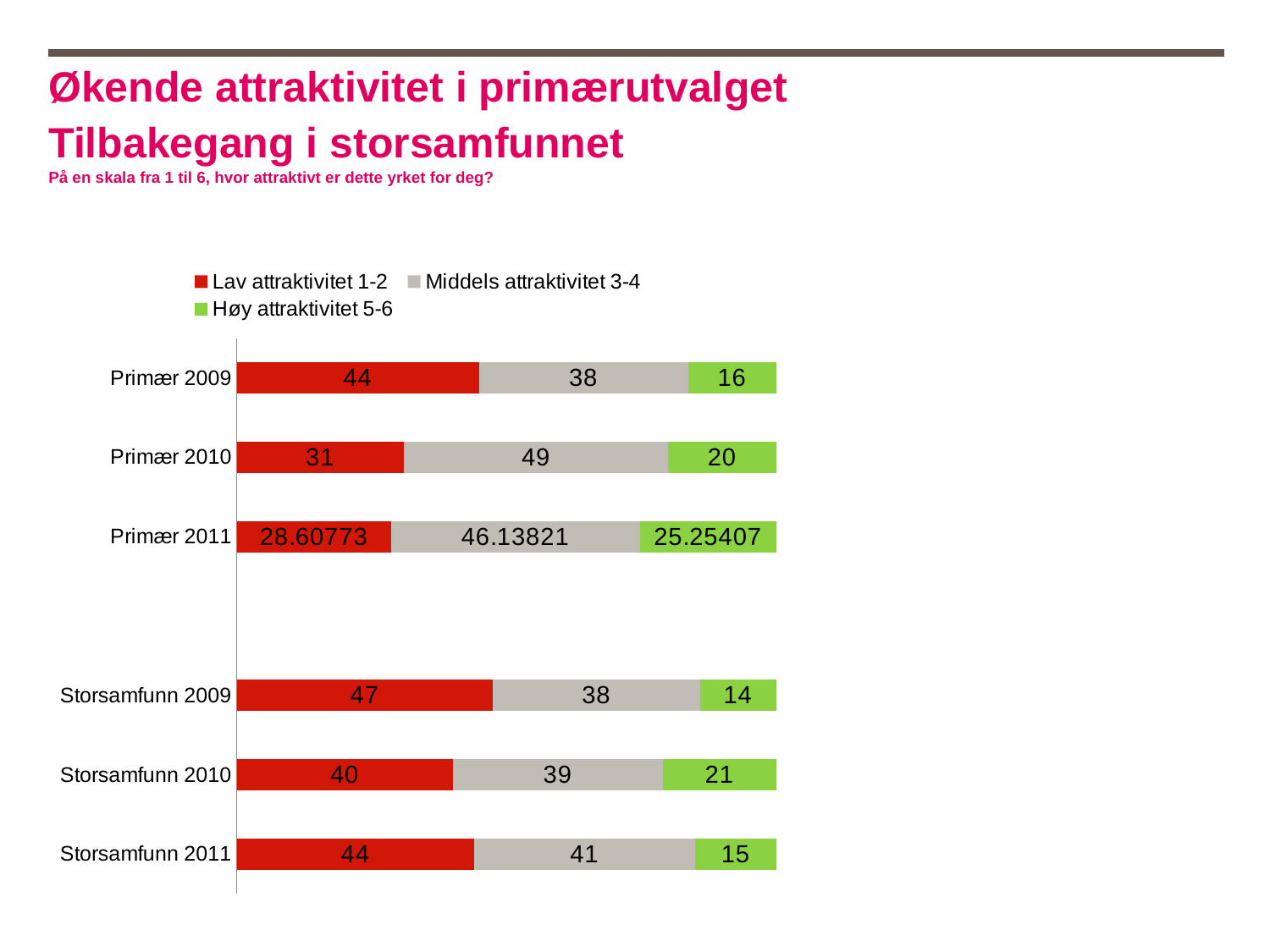
How many series does the legend list? 3 What is the value of Høy attraktivitet 5-6 for Storsamfunn 2010? 21 Which is larger: Høy attraktivitet 5-6 for Primær 2010 or for Storsamfunn 2011? Primær 2010 Which category has the highest value for Lav attraktivitet 1-2? Storsamfunn 2009 What kind of chart is shown on the slide? Stacked bar chart Does the Høy attraktivitet 5-6 value for the Primær categories rise or fall from 2009 to 2011? Rise What is the value of Lav attraktivitet 1-2 for Primær 2009? 44 Which category has the lowest value for Høy attraktivitet 5-6? Storsamfunn 2009 Which category has the highest value for Middels attraktivitet 3-4? Primær 2010 What is the difference between the Lav attraktivitet 1-2 values for Primær 2009 and Primær 2010? 13 What is the value of Middels attraktivitet 3-4 for Primær 2011? 46.13821 What is the total of the stacked bar for Storsamfunn 2011? 100